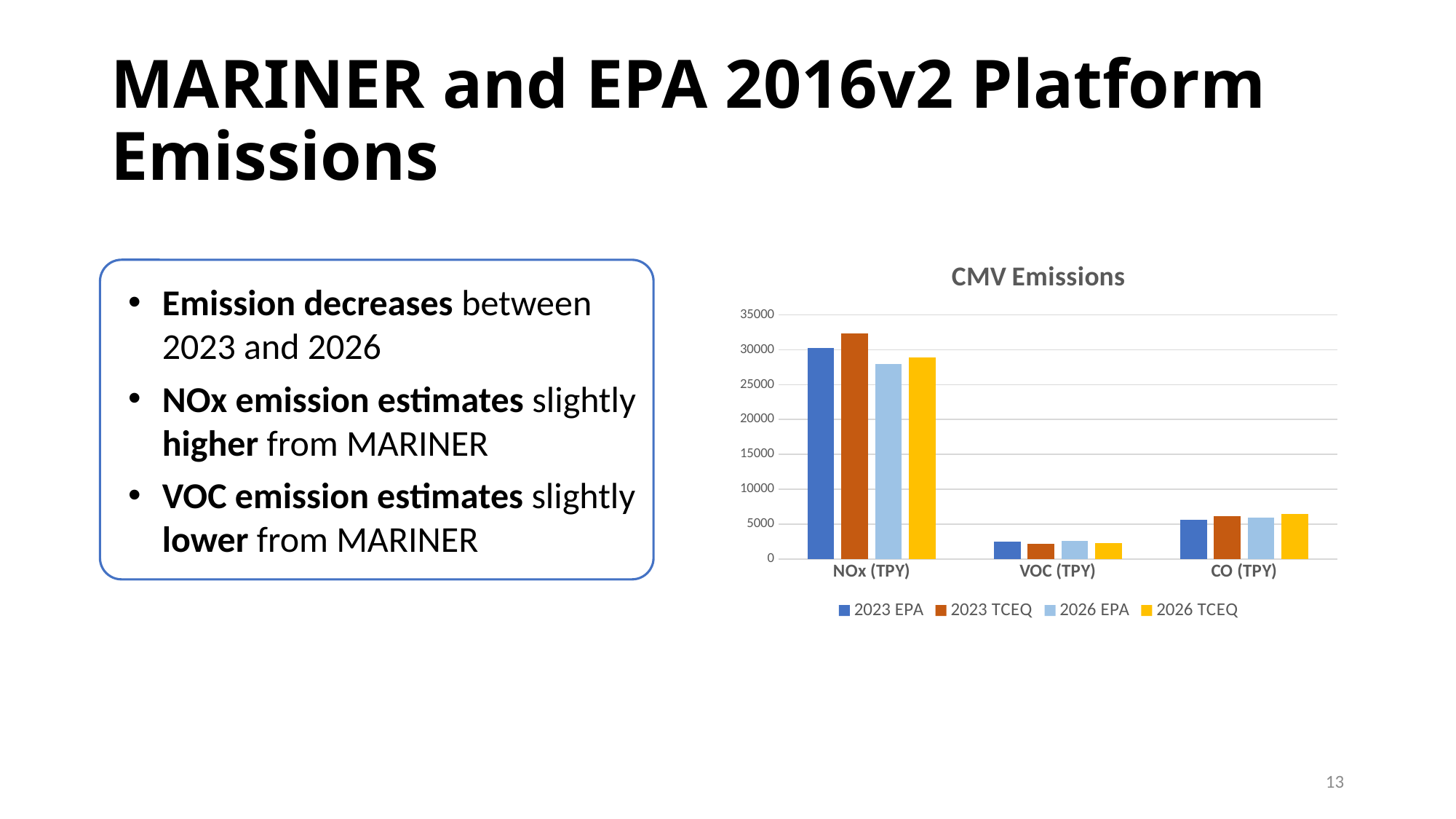
Is the value for 2026 EPA in NOx (TPY) greater or less than 30000? less Is the value for 2026 TCEQ in CO (TPY) greater or less than 5000? greater What kind of chart is shown on the slide? bar chart Which category has the highest emissions in the chart? NOx (TPY) Is the value for 2023 EPA in VOC (TPY) greater or less than 5000? less Which category has the lowest emissions in the chart? VOC (TPY) For NOx (TPY), which series has the highest bar? 2023 TCEQ For NOx (TPY), which is larger: 2023 TCEQ or 2026 EPA? 2023 TCEQ How many categories are shown on the x axis of the chart? 3 How many series does the chart's legend list? 4 What is the title of the chart? CMV Emissions